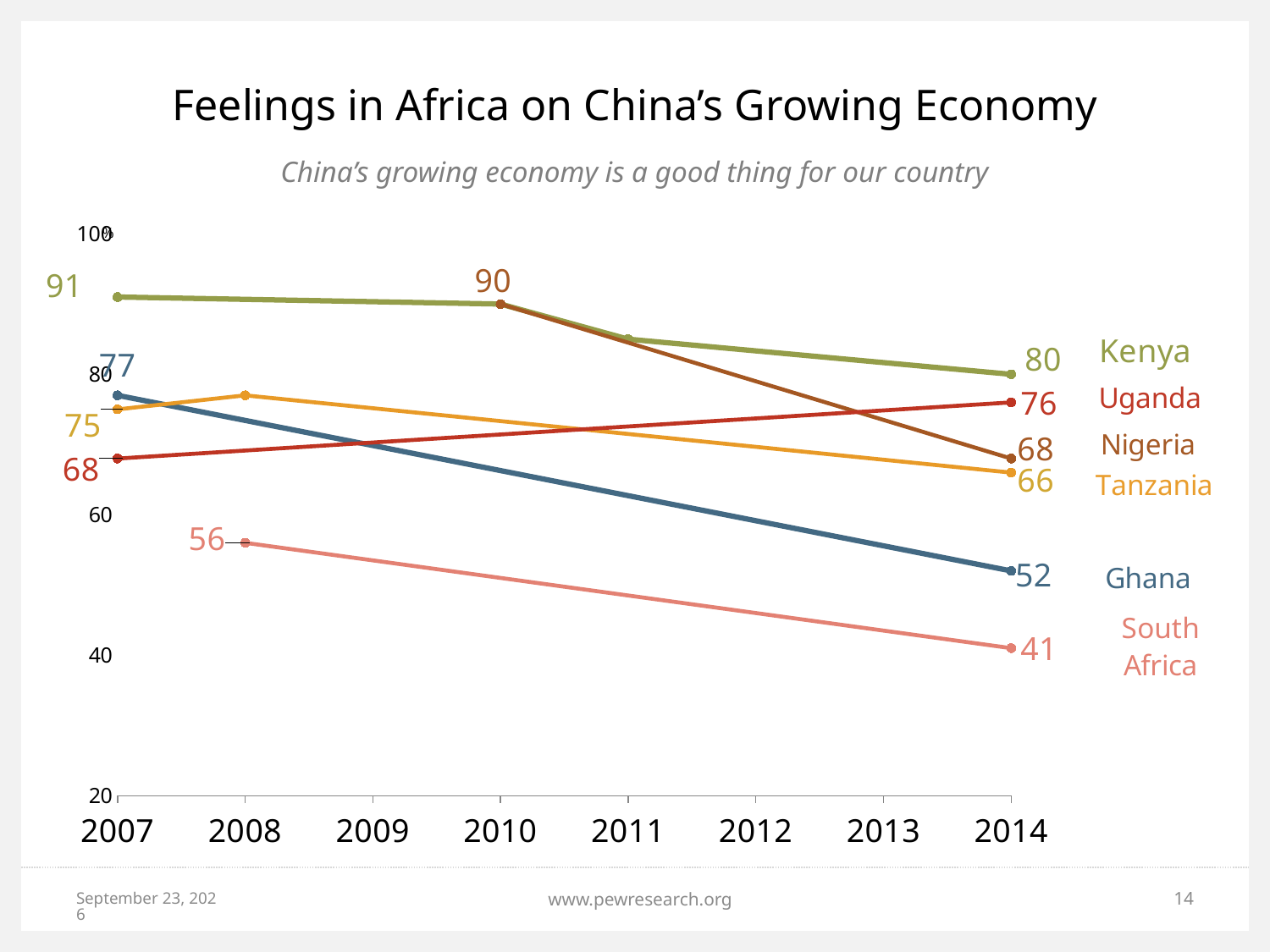
Does the value for Uganda rise or fall from 2007 to 2014? rise What is the value for South Africa in 2014? 41 What kind of chart is shown on the slide? line chart What is the value for Nigeria in 2010? 90 Which country has the lowest value in 2014? South Africa How many countries (series) are plotted on the chart? 6 By how much did Ghana's value fall from 2007 to 2014? 25 What is the value for Uganda in 2007? 68 Which country has the highest value in 2014? Kenya Is the value for Tanzania in 2008 greater or less than 80? less Which is larger in 2014, the value for Uganda or the value for Nigeria? Uganda What is the value for Kenya in 2014? 80